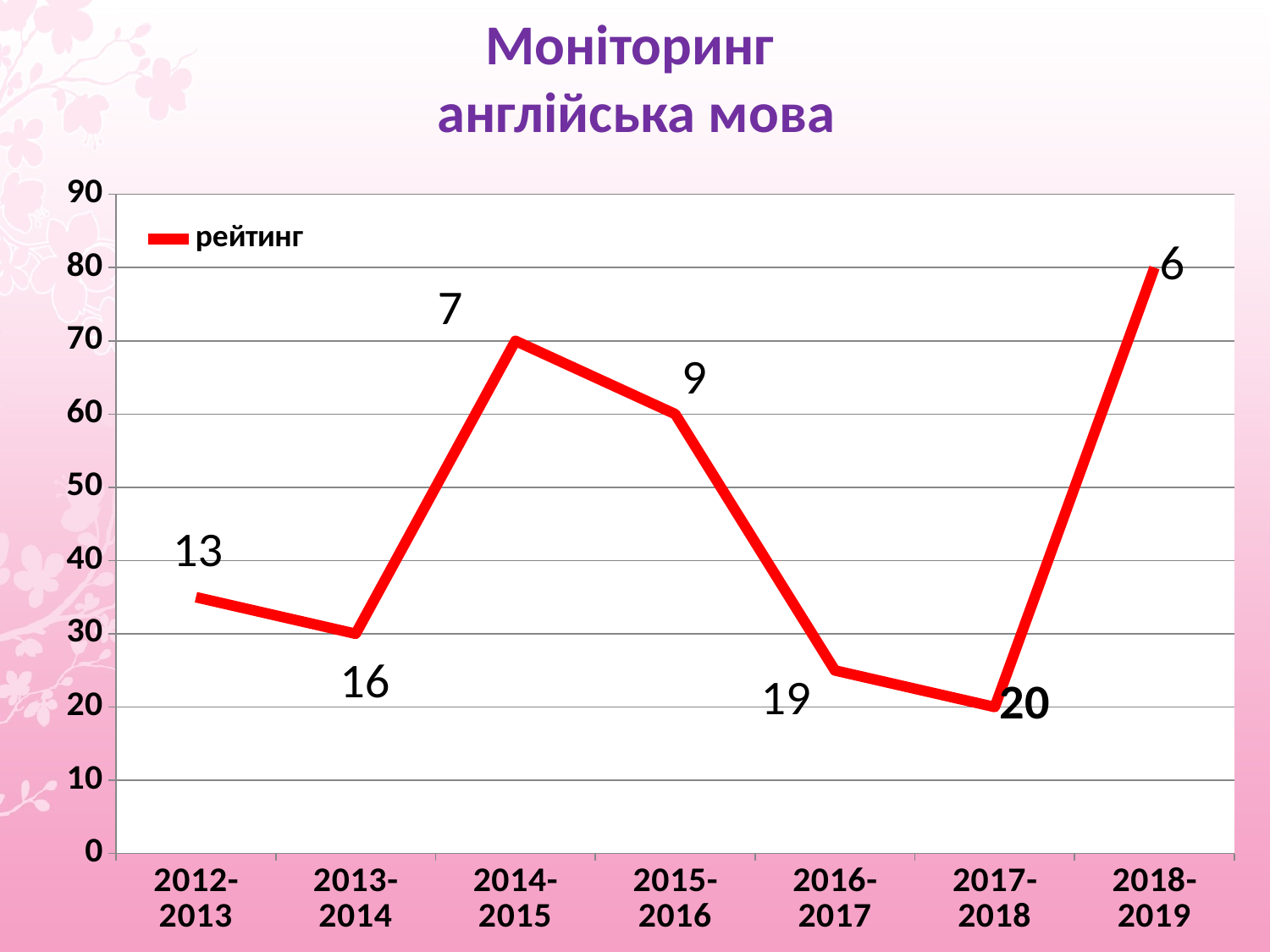
What number is printed as the label next to the point for 2016-2017? 19 Which school year has the highest point on the line? 2018-2019 Is the plotted point for 2012-2013 greater or less than 30 on the vertical axis? greater How many school-year categories are plotted along the x axis? 7 Which school year has the lowest point on the line? 2017-2018 What number is printed as the label next to the point for 2012-2013? 13 What number is printed as the label next to the point for 2014-2015? 7 How many series does the legend list? 1 What is the name of the series shown in the legend? рейтинг What kind of chart is shown on the slide? line chart Is the plotted point for 2016-2017 greater or less than 30 on the vertical axis? less Does the line rise or fall from 2014-2015 to 2017-2018? fall